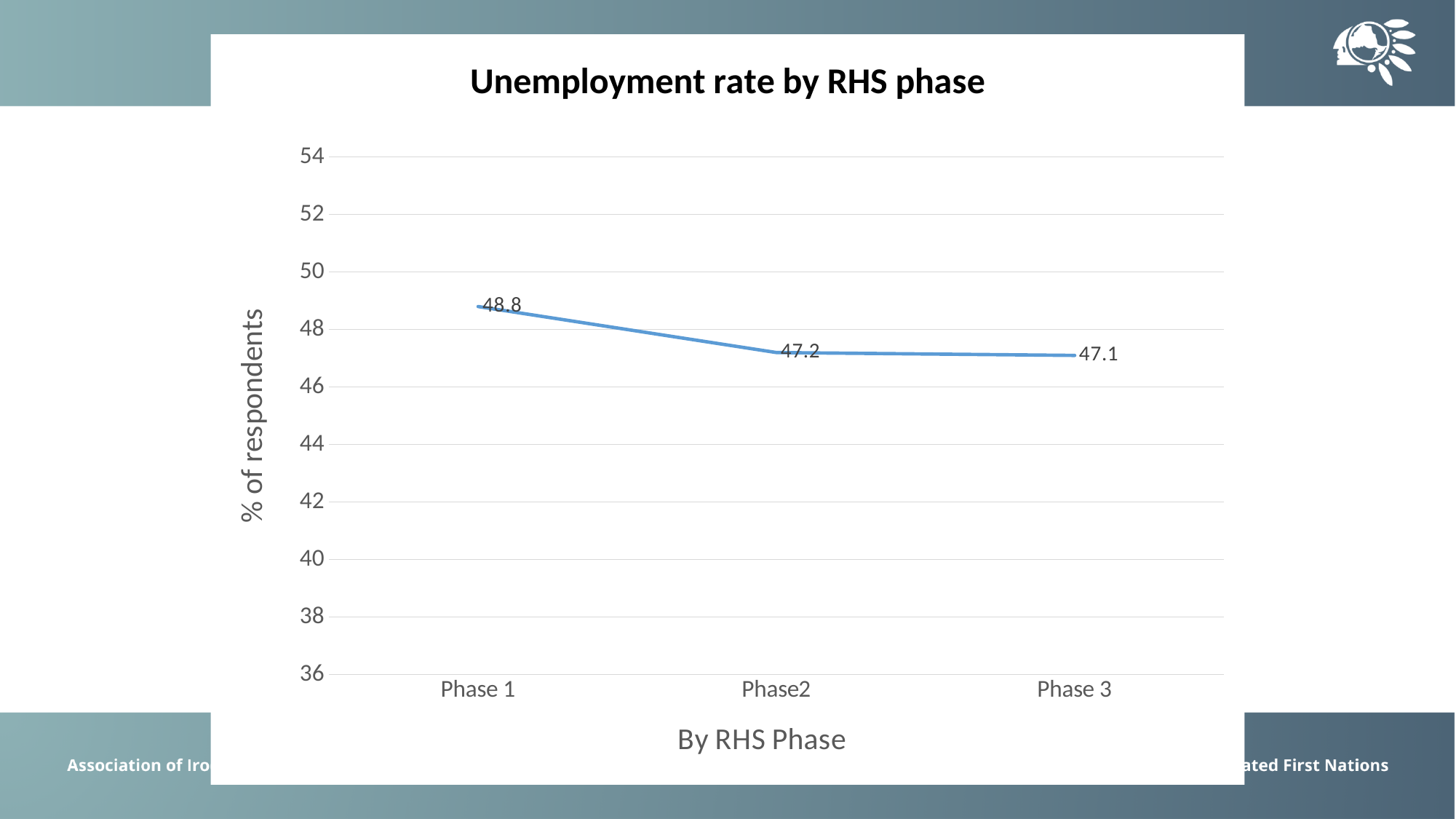
Does the unemployment rate rise or fall from Phase 1 to Phase 3? Fall Which phase has the highest unemployment rate? Phase 1 How many phases are plotted on the chart? 3 What is the difference between the unemployment rate in Phase 1 and Phase2? 1.6 Is the value for Phase 1 greater or less than 48? greater What is the title of the chart? Unemployment rate by RHS phase What is the unemployment rate for Phase 1? 48.8 What kind of chart is shown on the slide? Line chart Is the unemployment rate higher in Phase 1 or Phase 3? Phase 1 What is the difference between the unemployment rate in Phase 1 and Phase 3? 1.7 What is the unemployment rate for Phase 3? 47.1 What is the unemployment rate for Phase2? 47.2